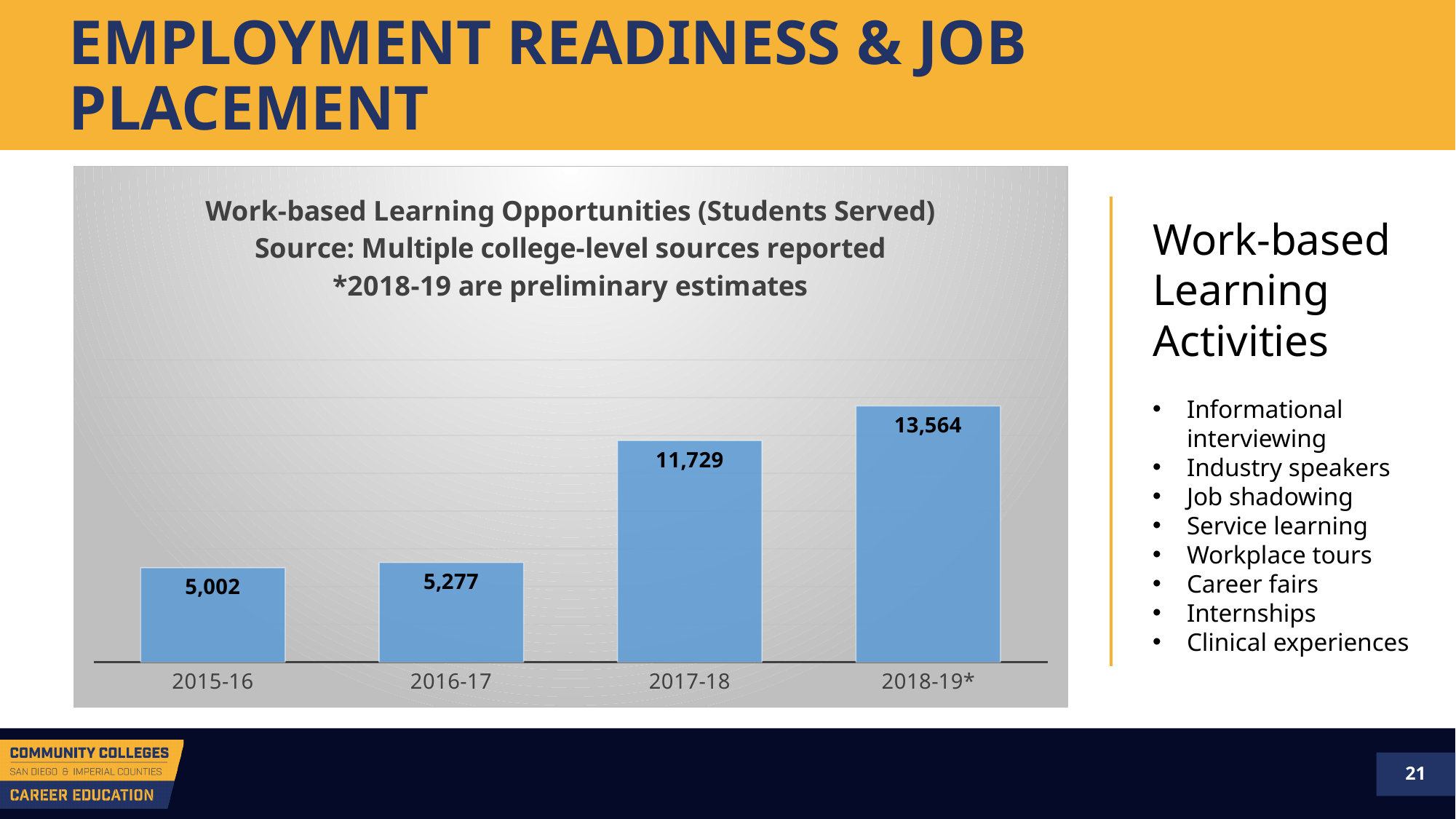
What is the number of students served in 2018-19*? 13,564 What is the number of students served in 2015-16? 5,002 Which year had more students served, 2017-18 or 2016-17? 2017-18 What is the number of students served in 2016-17? 5,277 Which year has the highest number of students served? 2018-19* What is the difference in students served between 2018-19* and 2017-18? 1,835 What is the difference in students served between 2016-17 and 2015-16? 275 What is the number of students served in 2017-18? 11,729 Do the values rise or fall from 2015-16 to 2018-19*? Rise How many years are shown on the x axis of the chart? 4 What type of chart is shown on the slide? Bar chart Which year has the lowest number of students served? 2015-16